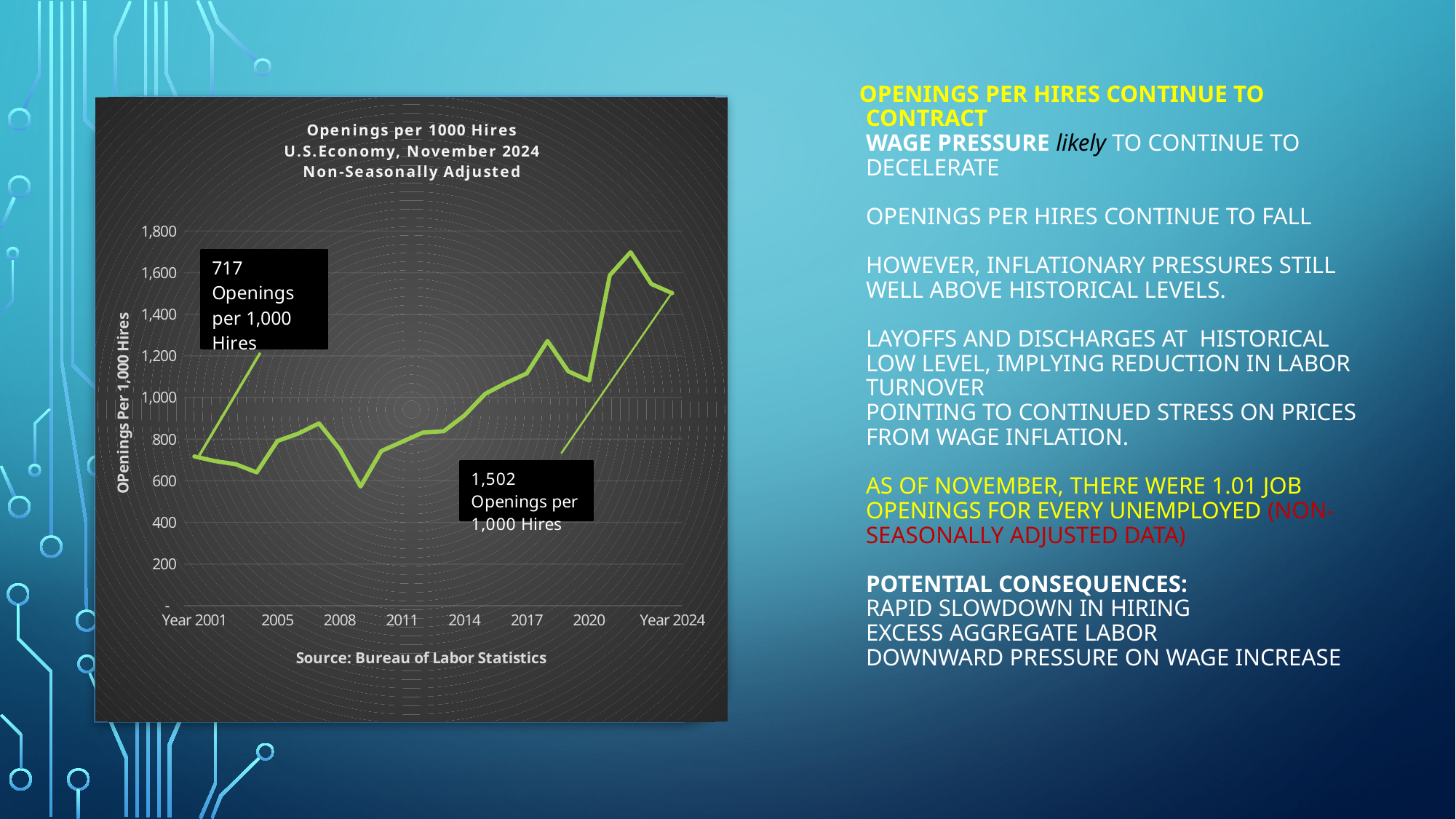
Which year has the larger value of openings per 1,000 hires, Year 2001 or Year 2024? Year 2024 What is the difference between the openings per 1,000 hires in Year 2024 and Year 2001? 785 How many year labels are shown on the x axis of the chart? 8 What source is cited below the chart? Bureau of Labor Statistics Overall, do the openings per 1,000 hires rise or fall from Year 2001 to Year 2024? rise Is the value for 2008 greater or less than 1,000? less What is the title of the chart? Openings per 1000 Hires U.S. Economy, November 2024 Non-Seasonally Adjusted What is the value of openings per 1,000 hires for Year 2024? 1,502 Is the value for 2017 greater or less than 1,000? greater What kind of chart is shown on the slide? line chart Is the value for 2011 greater or less than 1,000? less What is the value of openings per 1,000 hires for Year 2001? 717